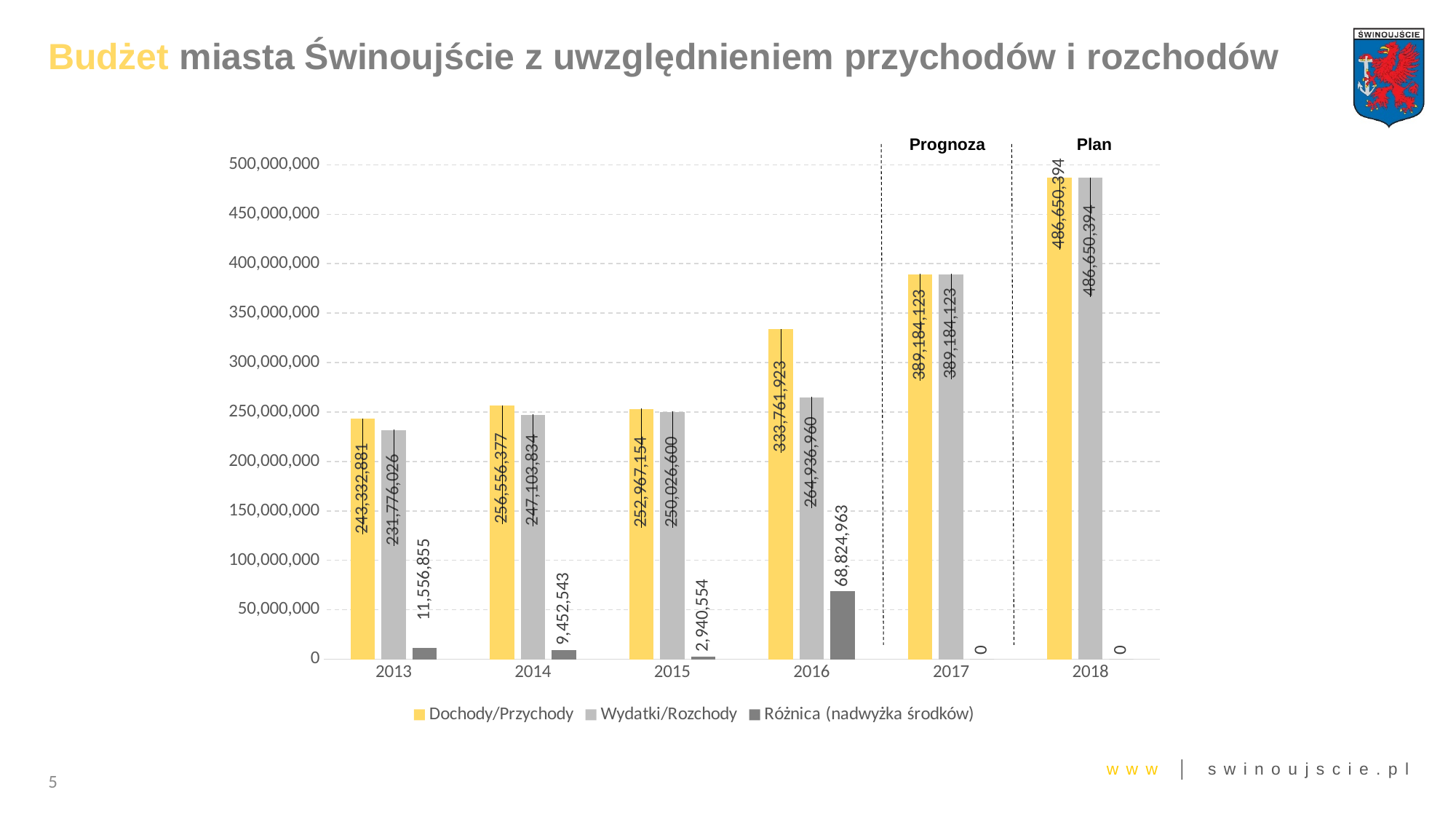
What is the value of Wydatki/Rozchody for 2014? 247,103,834 Is the value of Wydatki/Rozchody for 2017 greater or less than 350,000,000? greater What is the value of Różnica (nadwyżka środków) for 2013? 11,556,855 Which year has the highest Różnica (nadwyżka środków)? 2016 What kind of chart is shown on the slide? bar chart How many years are shown on the x axis? 6 What is the difference between Dochody/Przychody and Wydatki/Rozchody in 2015? 2,940,554 Which year has the lowest Dochody/Przychody? 2013 How many series does the legend list? 3 Which is larger in 2016: Dochody/Przychody or Wydatki/Rozchody? Dochody/Przychody What is the value of Dochody/Przychody for 2018? 486,650,394 What is the value of Dochody/Przychody for 2016? 333,761,923